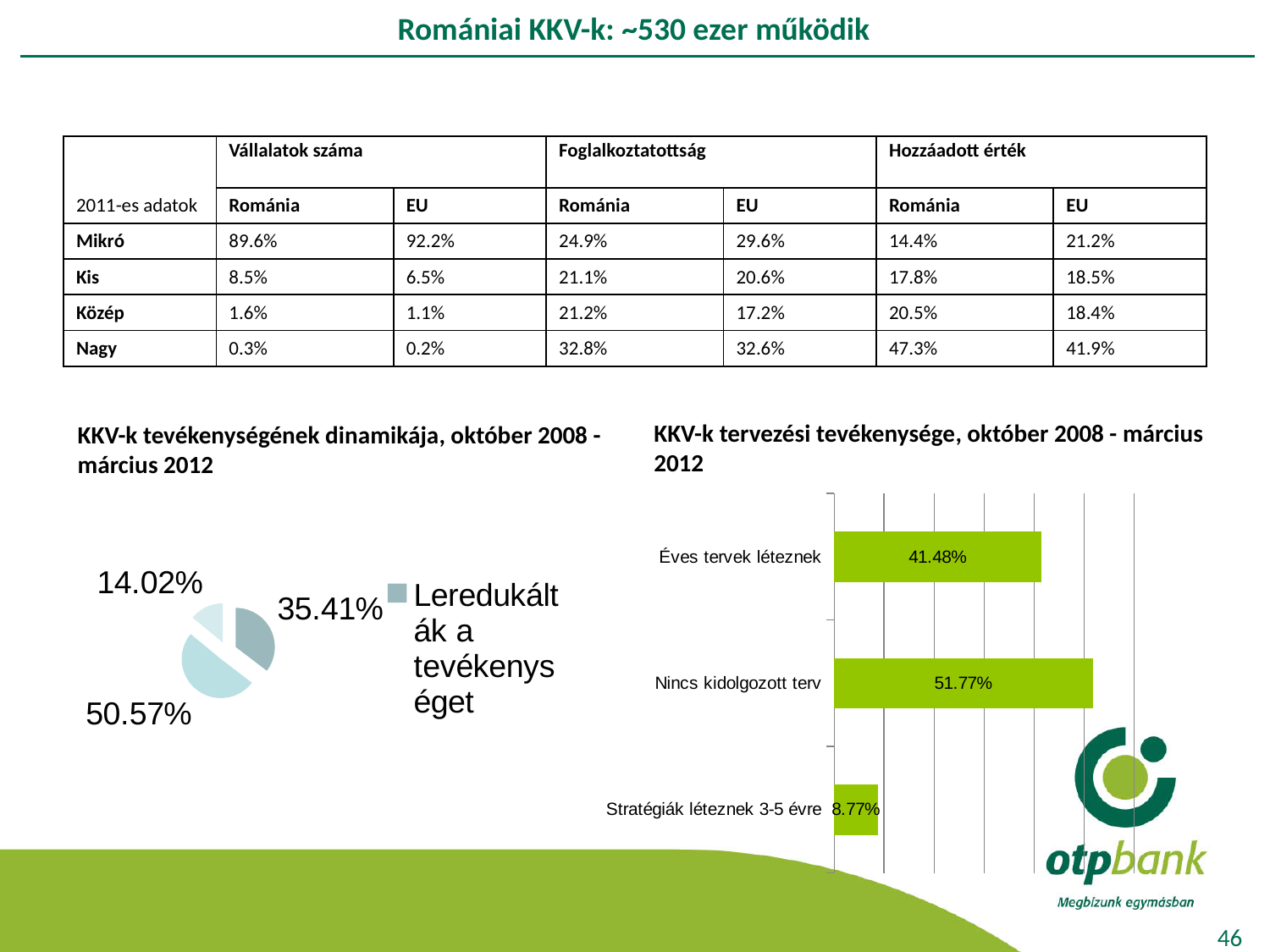
How many slices does the pie chart on the bottom left of the slide have? 3 What kind of chart is the chart on the right of the slide, titled 'KKV-k tervezési tevékenysége, október 2008 - március 2012'? Bar chart In the pie chart on the bottom left of the slide, what is the value of the largest slice? 50.57% How many categories are shown in the bar chart titled 'KKV-k tervezési tevékenysége, október 2008 - március 2012'? 3 In the bar chart titled 'KKV-k tervezési tevékenysége, október 2008 - március 2012', what is the difference between 'Nincs kidolgozott terv' and 'Éves tervek léteznek'? 10.29% In the bar chart titled 'KKV-k tervezési tevékenysége, október 2008 - március 2012', what is the value for 'Nincs kidolgozott terv'? 51.77% What kind of chart is the chart on the bottom left of the slide, under the heading 'KKV-k tevékenységének dinamikája, október 2008 - március 2012'? Pie chart In the bar chart titled 'KKV-k tervezési tevékenysége, október 2008 - március 2012', which is larger: 'Éves tervek léteznek' or 'Stratégiák léteznek 3-5 évre'? Éves tervek léteznek In the bar chart titled 'KKV-k tervezési tevékenysége, október 2008 - március 2012', which category has the lowest value? Stratégiák léteznek 3-5 évre In the bar chart titled 'KKV-k tervezési tevékenysége, október 2008 - március 2012', what is the value for 'Stratégiák léteznek 3-5 évre'? 8.77% In the bar chart titled 'KKV-k tervezési tevékenysége, október 2008 - március 2012', which category has the highest value? Nincs kidolgozott terv In the bar chart titled 'KKV-k tervezési tevékenysége, október 2008 - március 2012', what is the value for 'Éves tervek léteznek'? 41.48%